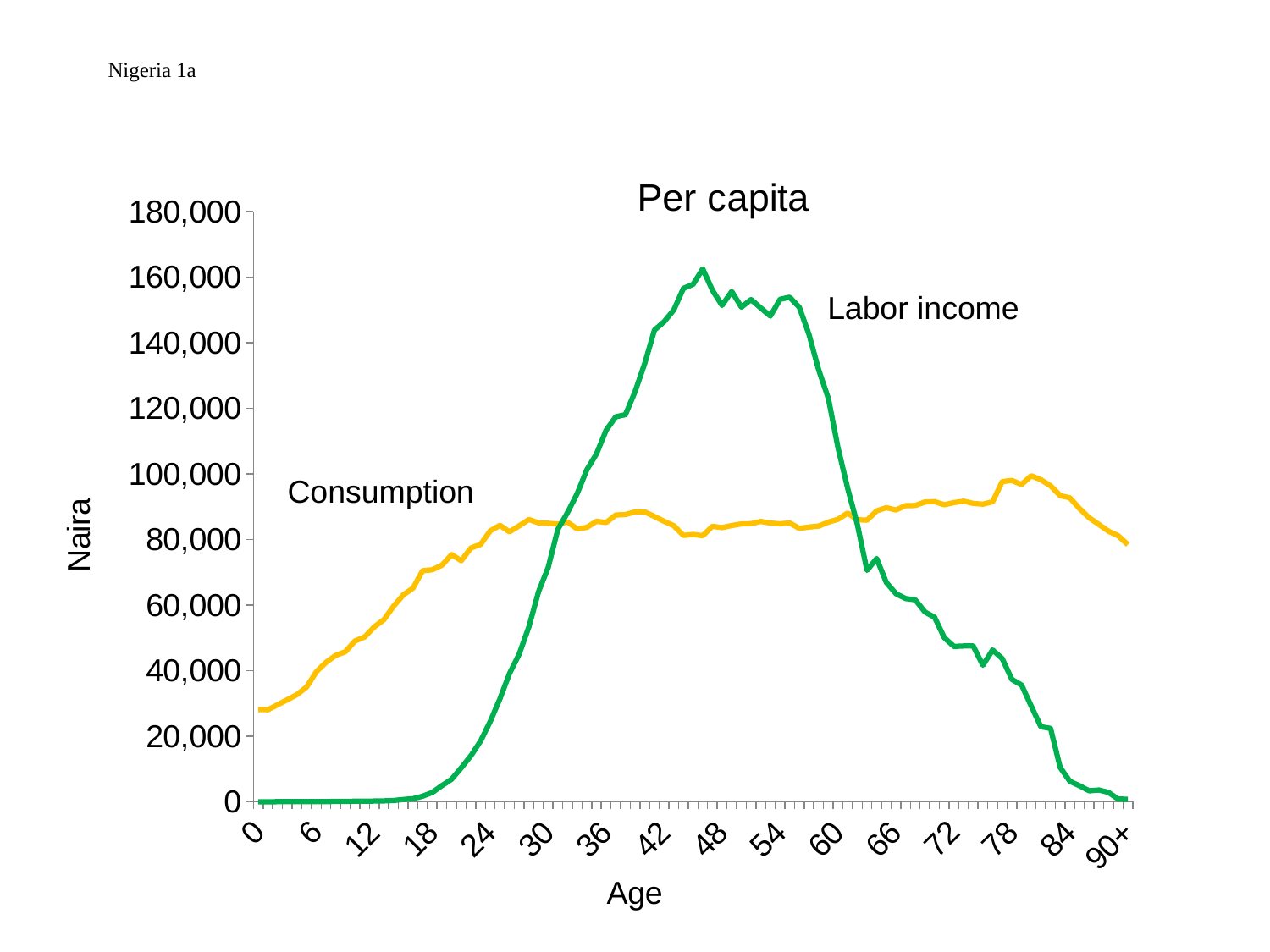
At age 24, which series has the higher value, Labor income or Consumption? Consumption How many series are plotted on the chart? 2 What is the title of the chart? Per capita Does Labor income rise or fall between age 60 and age 90+? Fall Is the value for Consumption at age 0 greater or less than 40,000? less Is the value for Consumption at age 78 greater or less than 80,000? greater At age 48, which series has the higher value, Labor income or Consumption? Labor income What is the label on the vertical axis of the chart? Naira Is the value for Labor income at age 48 greater or less than 140,000? greater What kind of chart is shown on the slide? Line chart Does Labor income rise or fall between age 18 and age 42? Rise